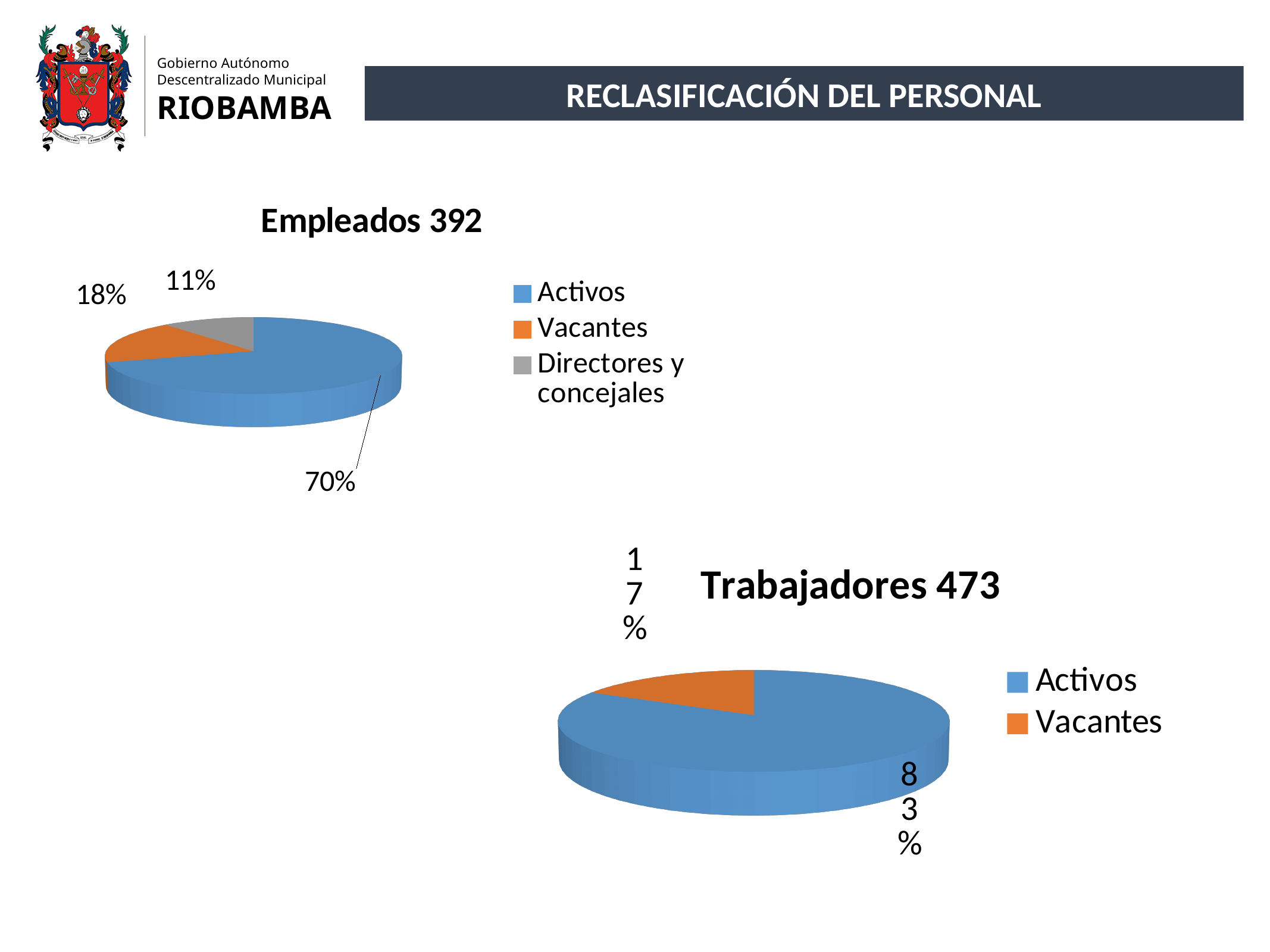
In the 'Empleados 392' chart, which category has the smallest slice? Directores y concejales In the 'Empleados 392' chart, how many categories does the legend list? 3 In the 'Empleados 392' chart, what share of the pie is Directores y concejales? 11% In the 'Trabajadores 473' chart, what share of the pie is Vacantes? 17% In the 'Empleados 392' chart, what share of the pie is Activos? 70% In the 'Empleados 392' chart, what is the difference in percentage points between Activos and Vacantes? 52 In the 'Empleados 392' chart, which category has the largest slice? Activos What kind of chart is the 'Trabajadores 473' chart? Pie chart In the 'Trabajadores 473' chart, which is larger, Activos or Vacantes? Activos In the 'Trabajadores 473' chart, what colour represents Vacantes? Orange